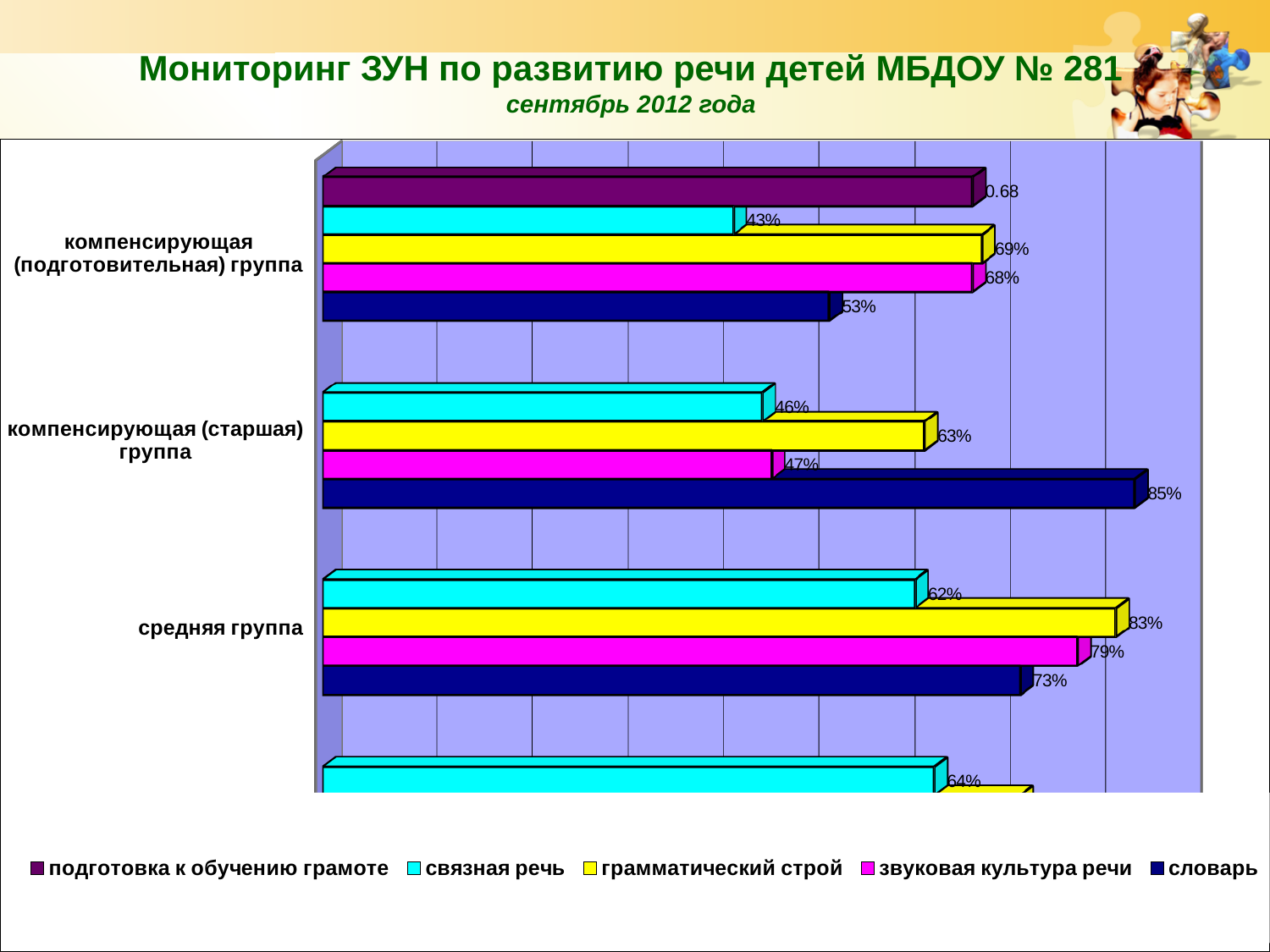
Which series has the highest value for средняя группа? грамматический строй What value is labelled on the подготовка к обучению грамоте bar for компенсирующая (подготовительная) группа? 0.68 What is the value of словарь for компенсирующая (старшая) группа? 85% How many series does the legend list? 5 What is the difference between the словарь values for компенсирующая (старшая) группа and средняя группа? 12% Which group has the highest value for словарь? компенсирующая (старшая) группа What kind of chart is shown on the slide? bar chart Which group has the larger value for звуковая культура речи: средняя группа or компенсирующая (подготовительная) группа? средняя группа What is the difference between the грамматический строй values for средняя группа and компенсирующая (старшая) группа? 20% What is the value of связная речь for компенсирующая (подготовительная) группа? 43% Which series has the lowest value for компенсирующая (подготовительная) группа? связная речь What is the value of грамматический строй for средняя группа? 83%